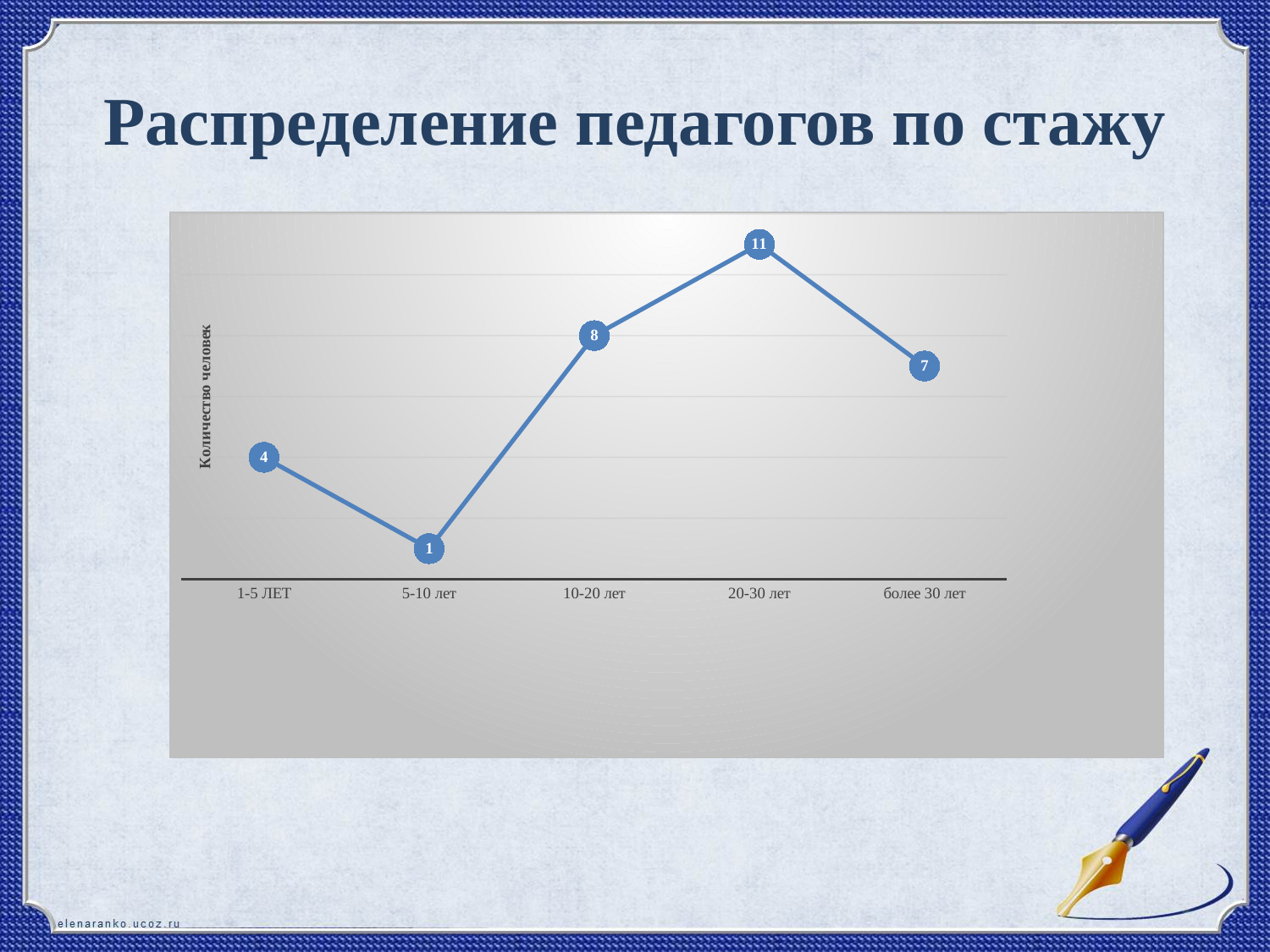
How many categories are plotted on the x axis? 5 What is the difference between the values for 20-30 лет and более 30 лет? 4 What is the value for the более 30 лет category? 7 What is the value for the 20-30 лет category? 11 What is the label of the vertical axis? Количество человек Which is larger, the value for 1-5 ЛЕТ or the value for более 30 лет? более 30 лет What kind of chart is shown on the slide? line chart What is the value for the 1-5 ЛЕТ category? 4 What is the value for the 10-20 лет category? 8 What is the value for the 5-10 лет category? 1 Which category has the highest value? 20-30 лет Which category has the lowest value? 5-10 лет